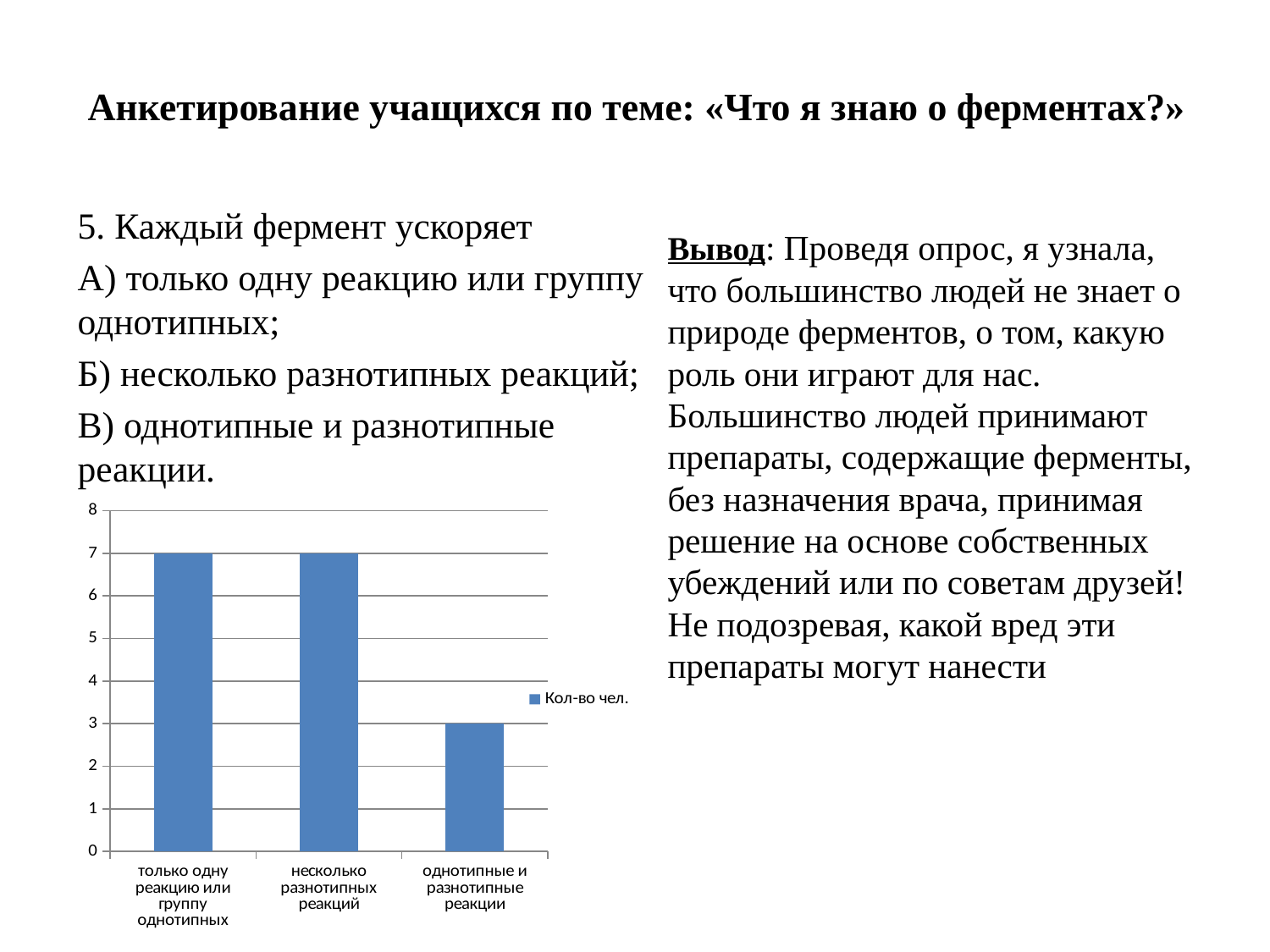
What kind of chart is shown on the slide? bar chart How many categories are shown on the x axis of the chart? 3 Is the value for "несколько разнотипных реакций" greater or less than 5? greater What is the value for "несколько разнотипных реакций"? 7 Which is larger: the value for "только одну реакцию или группу однотипных" or the value for "однотипные и разнотипные реакции"? только одну реакцию или группу однотипных What is the value for "однотипные и разнотипные реакции"? 3 What is the value for "только одну реакцию или группу однотипных"? 7 What is the difference between the values for "несколько разнотипных реакций" and "однотипные и разнотипные реакции"? 4 How many series does the chart legend list? 1 Is the value for "однотипные и разнотипные реакции" greater or less than 5? less Which category has the lowest value? однотипные и разнотипные реакции What is the legend entry of the chart? Кол-во чел.